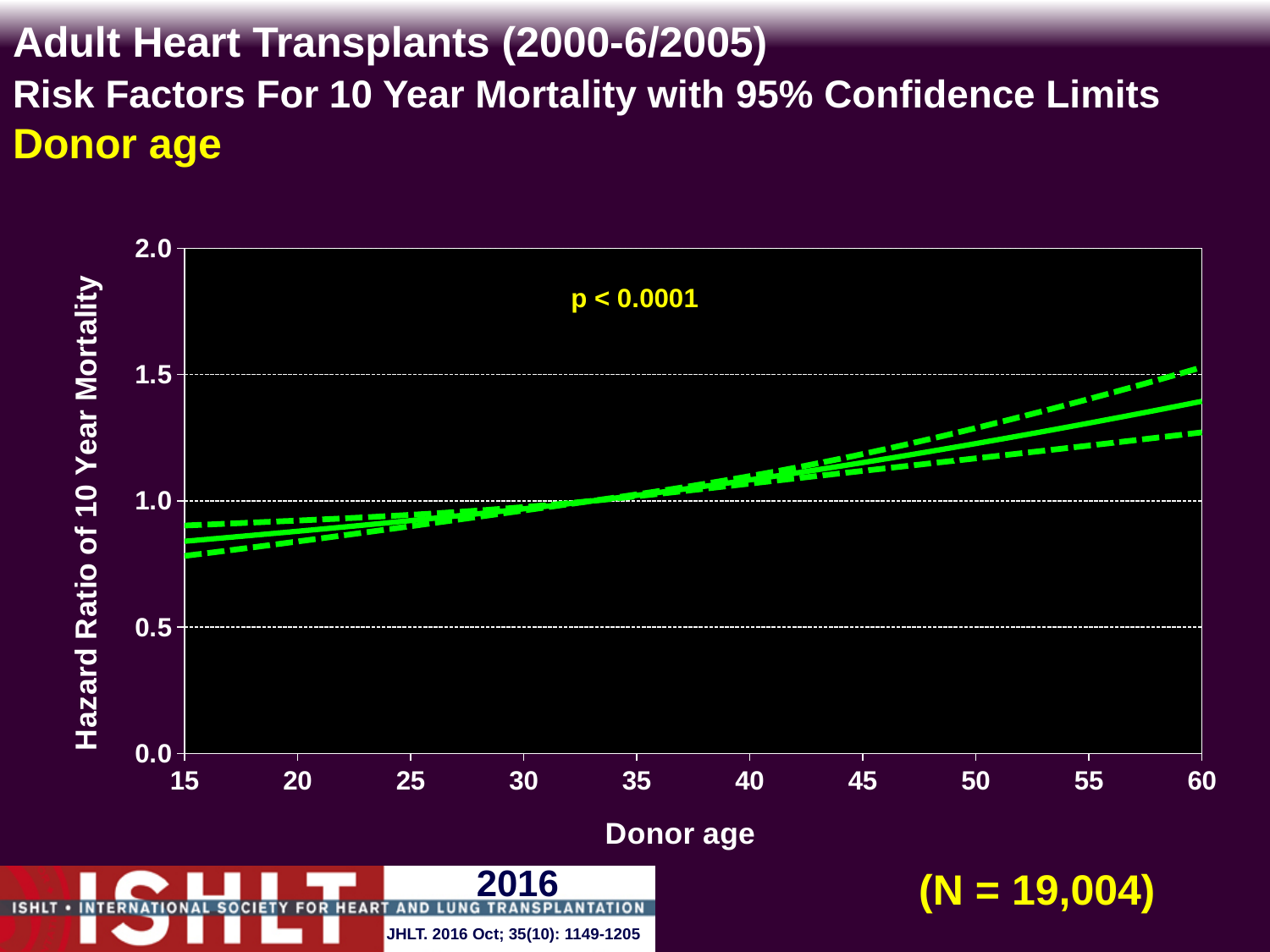
What is the label of the y axis? Hazard Ratio of 10 Year Mortality Is the hazard ratio (solid line) at donor age 60 greater or less than 1.5? less Which donor age has the larger hazard ratio of 10 year mortality, 15 or 60? 60 Is the upper 95% confidence limit at donor age 15 greater or less than 1.0? less Is the hazard ratio (solid line) at donor age 15 greater or less than 0.5? greater What kind of chart is shown on the slide? line chart Does the hazard ratio of 10 year mortality rise or fall as donor age increases from 15 to 60? rise How many lines are plotted on the chart? 3 What p-value is printed on the chart? p < 0.0001